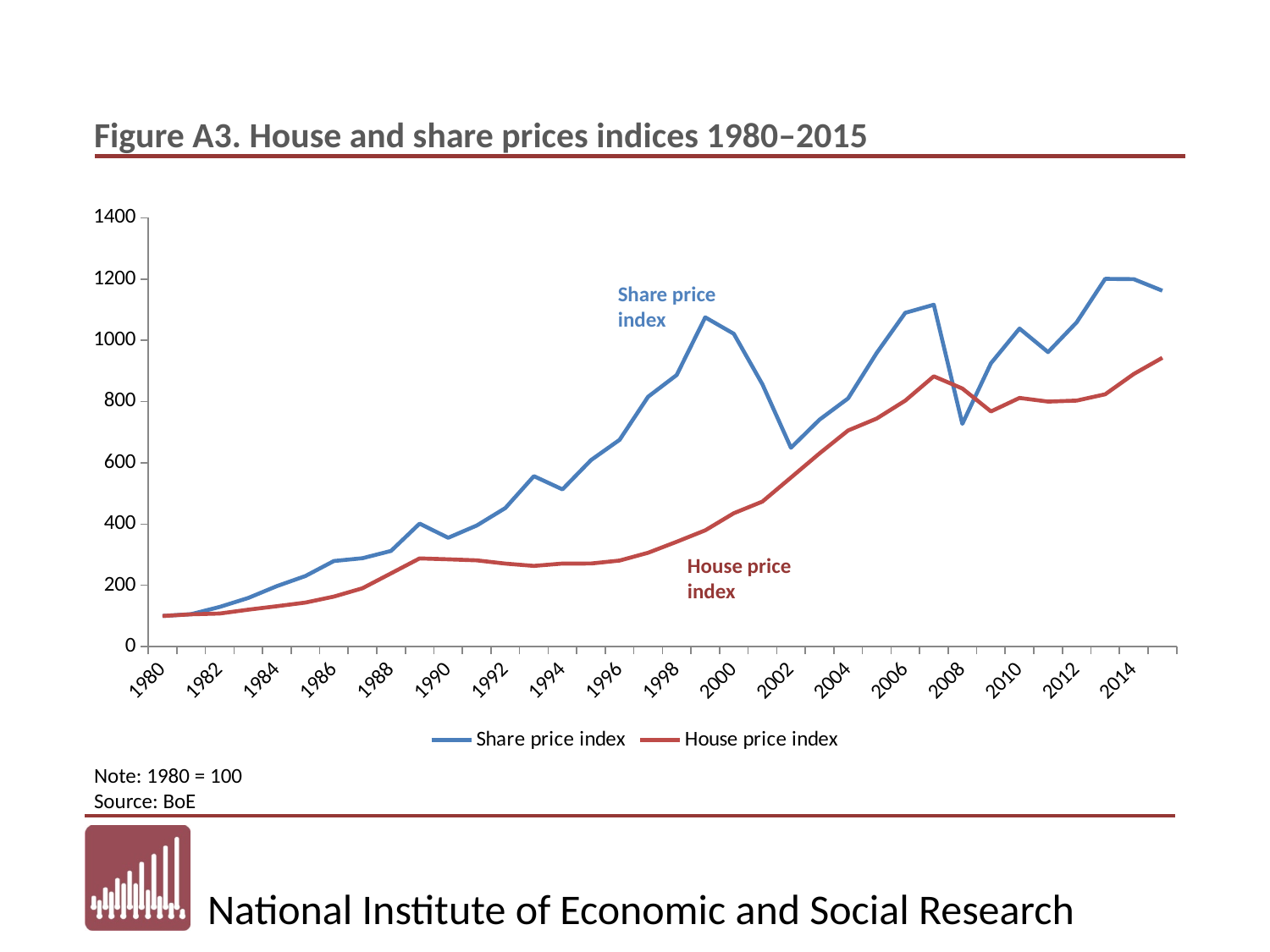
Is the value of the Share price index in 2002 greater or less than 800? less Is the value of the House price index in 1996 greater or less than 400? less Does the House price index rise or fall between 2009 and 2015? rise What is the value of both indices in 1980, according to the note? 100 How many series does the legend list? 2 Is the value of the House price index in 2007 greater or less than 800? greater What kind of chart is shown on the slide? line chart What are the two series named in the legend? Share price index and House price index What is the title of the chart? Figure A3. House and share prices indices 1980–2015 In 2008, which series has the higher value, the Share price index or the House price index? House price index In 2006, which series has the higher value, the Share price index or the House price index? Share price index